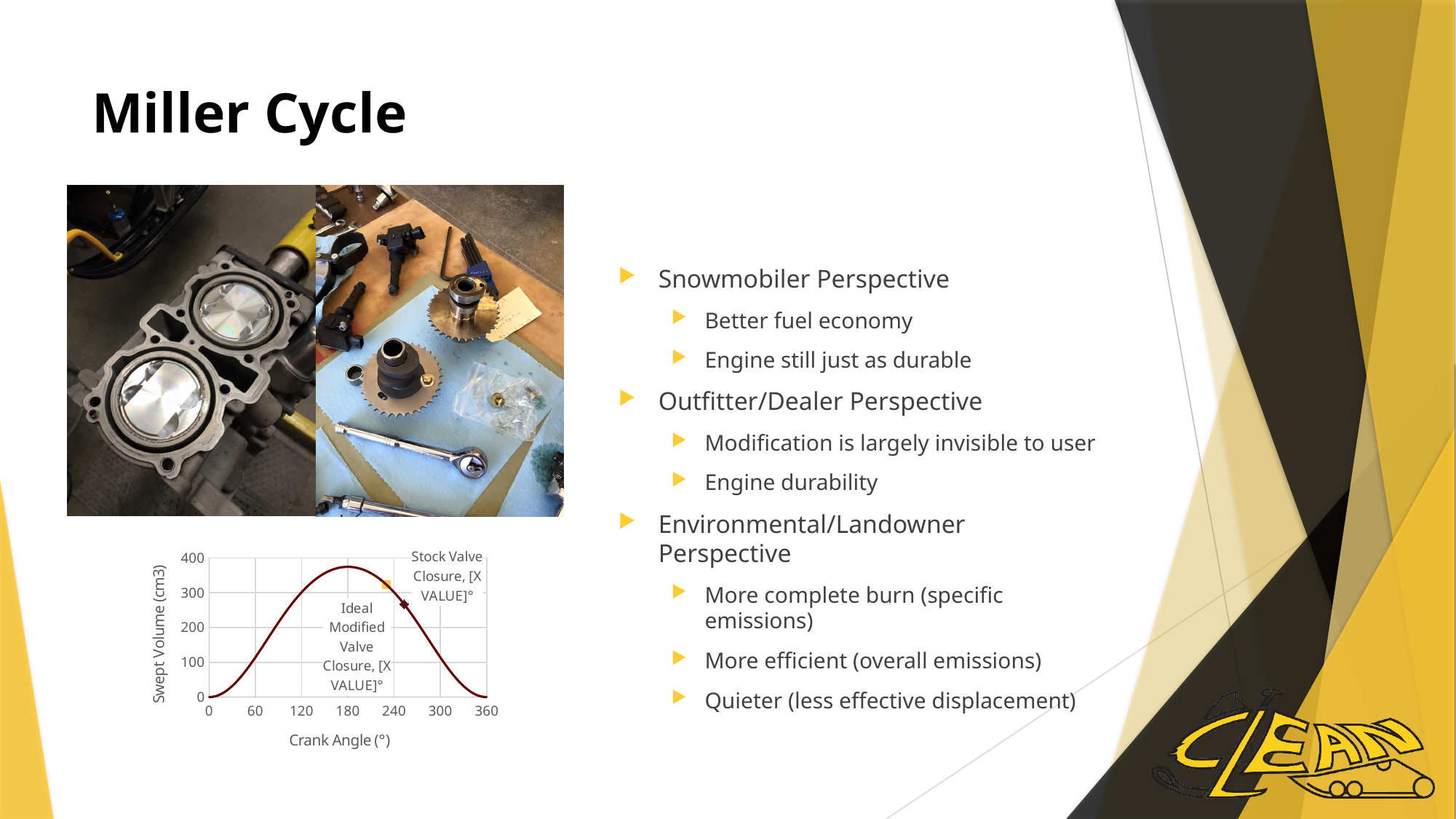
What is the title of the vertical axis of the chart? Swept Volume (cm3) Is the peak swept volume on the chart greater or less than 300? greater What is the title of the horizontal axis of the chart? Crank Angle (°) Is the swept volume at the Ideal Modified Valve Closure point greater or less than 300? less What kind of chart is shown on the slide? line chart Is the swept volume at a crank angle of 60° greater or less than 200? less Which marked point occurs at the larger crank angle, Stock Valve Closure or Ideal Modified Valve Closure? Ideal Modified Valve Closure How does the swept volume change as the crank angle increases from 0° to 360°? rises then falls How many labelled points are marked on the curve? 2 Which marked point has the higher swept volume, Stock Valve Closure or Ideal Modified Valve Closure? Stock Valve Closure